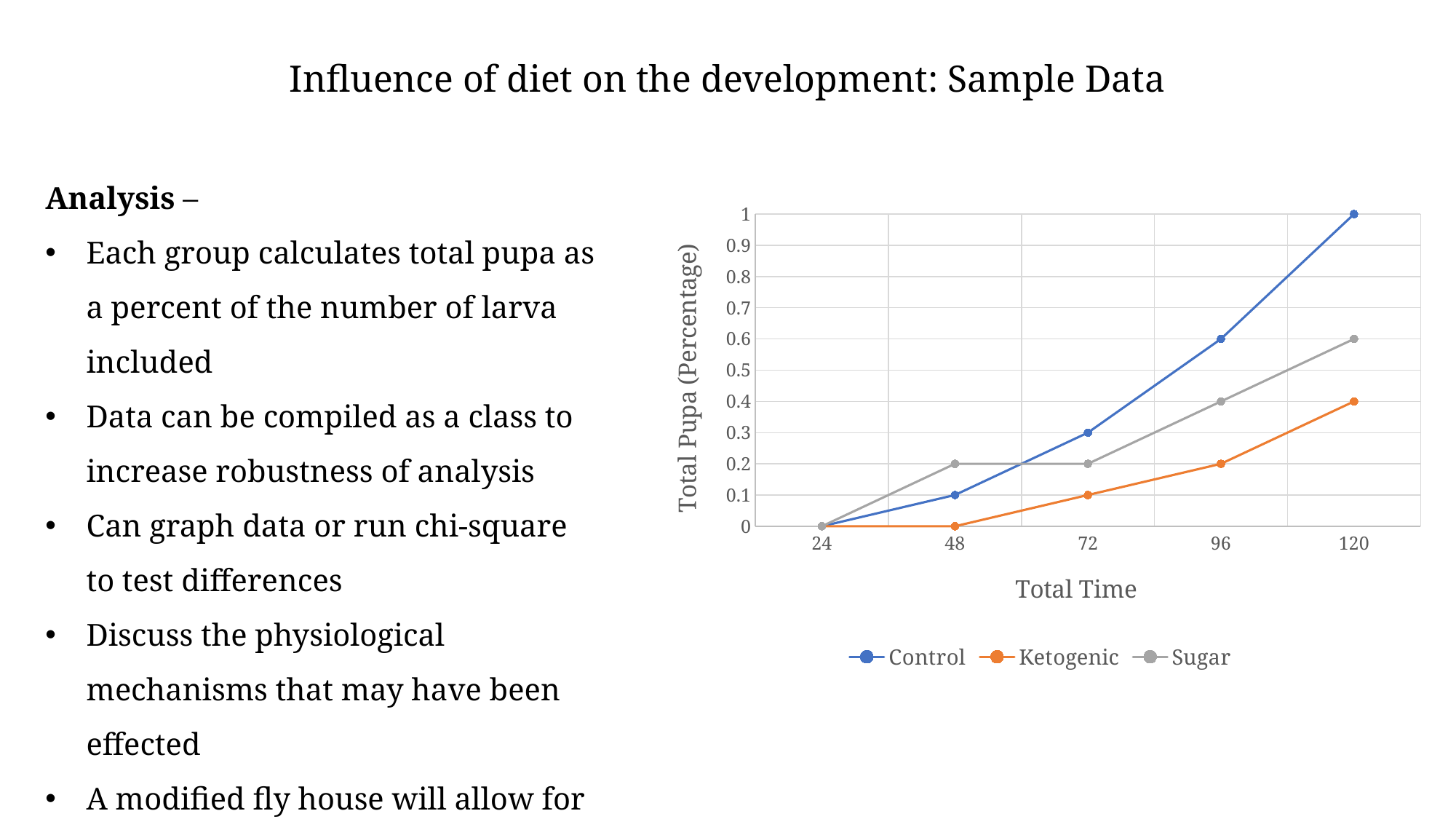
What is the value for Sugar at 48? 0.2 What is the difference between Control and Sugar at 120? 0.4 What is the value for Ketogenic at 96? 0.2 At 48, which is larger, Sugar or Control? Sugar Which series has the lowest value at 72? Ketogenic How many time points are plotted along the x axis? 5 Does the Control series rise or fall from 24 to 120? Rise How many series does the legend list? 3 What is the label of the y axis? Total Pupa (Percentage) Which series has the highest value at 120? Control What kind of chart is shown on the slide? Line chart What is the value for Control at 120? 1